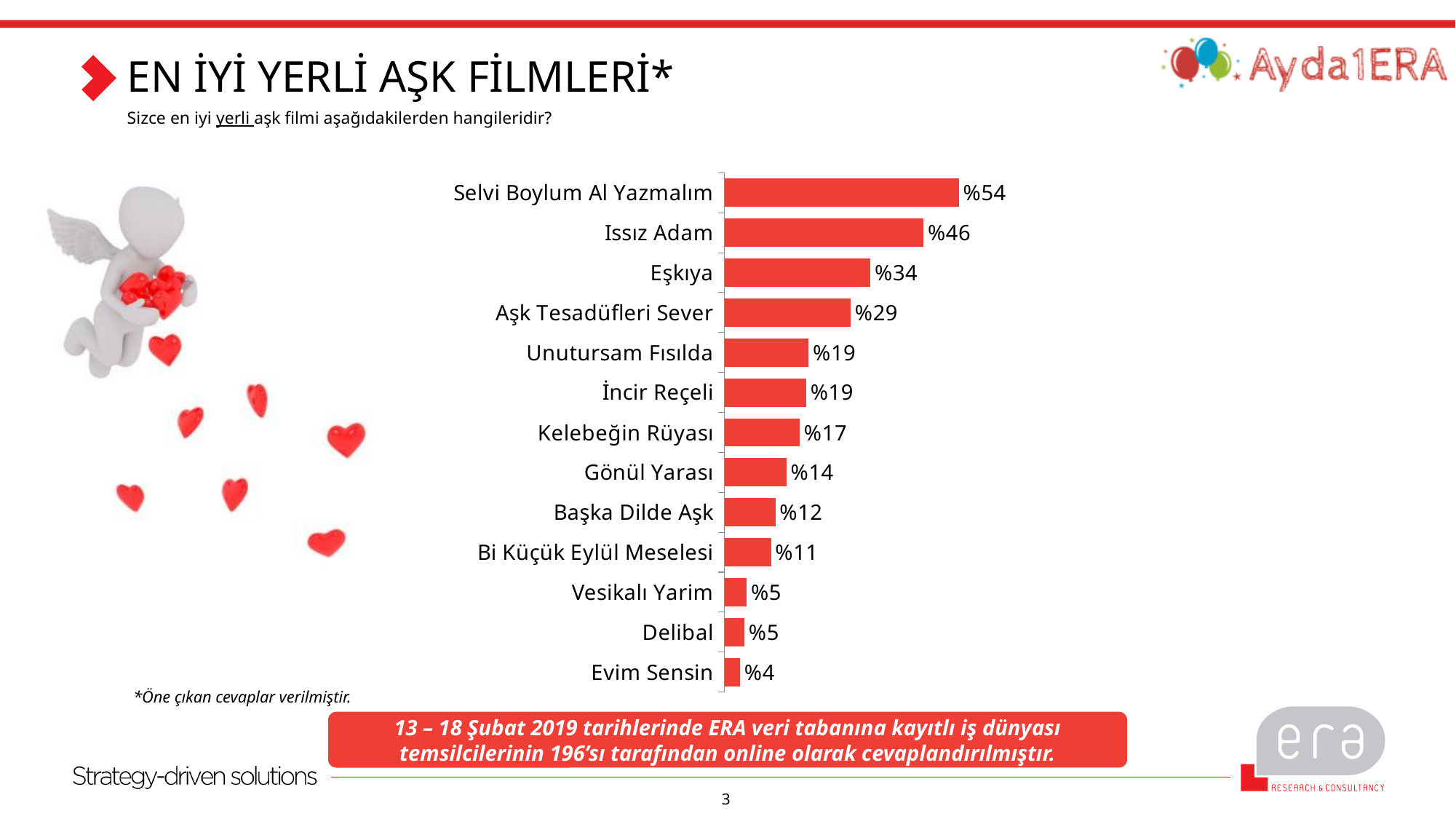
Which film has the highest value in the chart? Selvi Boylum Al Yazmalım What percentage of respondents chose Selvi Boylum Al Yazmalım as the best domestic love film? %54 What colour are the bars in the chart? Red What is the value shown for Eşkıya? %34 How many films are listed in the chart? 13 Which film has the lowest value in the chart? Evim Sensin What is the difference between the values for Selvi Boylum Al Yazmalım and Issız Adam? %8 What type of chart is shown on the slide? Bar chart What value is shown for Kelebeğin Rüyası? %17 What is the difference between the values for Aşk Tesadüfleri Sever and Gönül Yarası? %15 Which has a larger value, Issız Adam or Eşkıya? Issız Adam Which has a larger value, Başka Dilde Aşk or Bi Küçük Eylül Meselesi? Başka Dilde Aşk